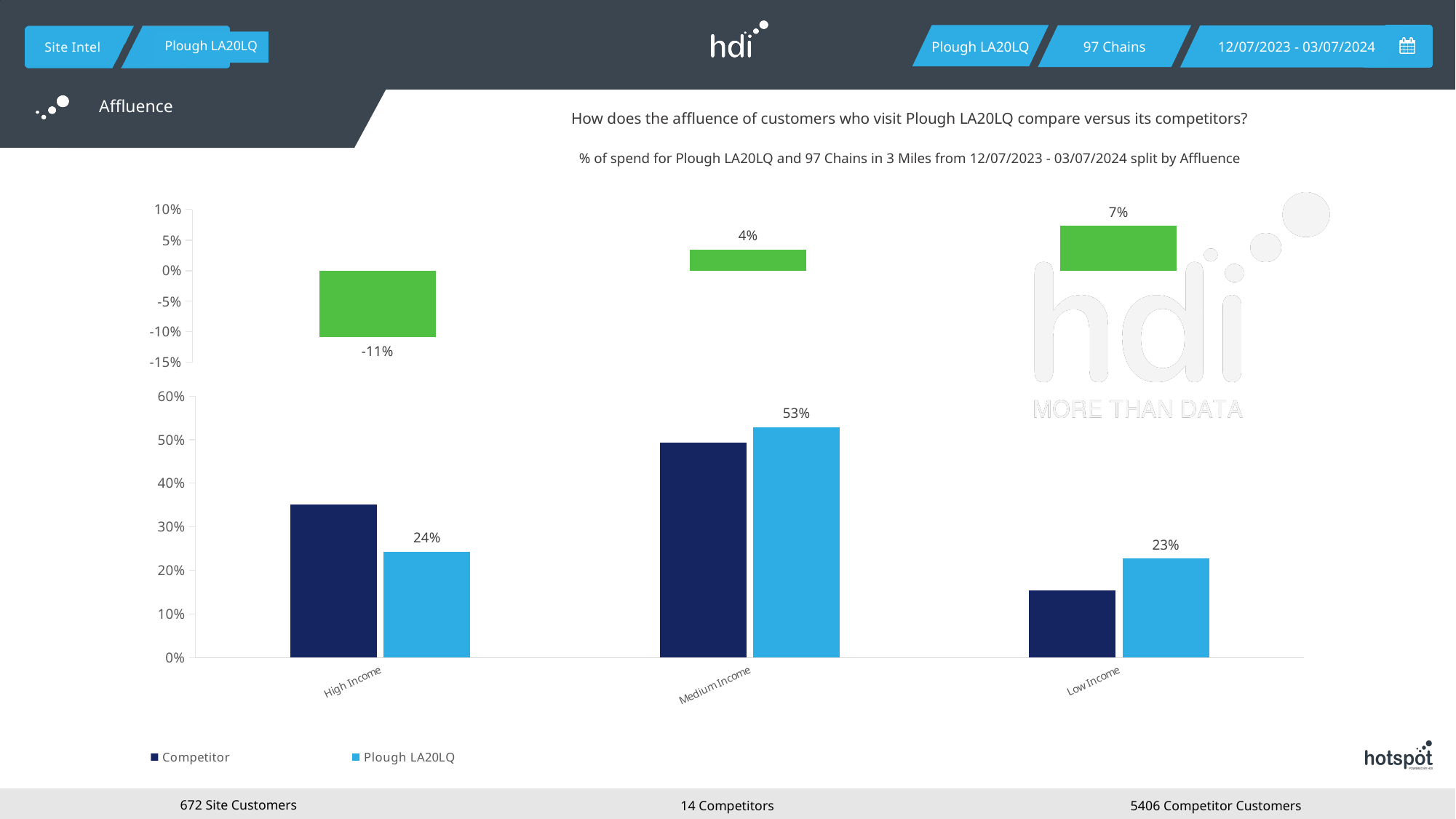
What type of chart is the bottom chart? Bar chart How many series does the legend of the bottom bar chart list? 2 In the bottom bar chart, is the Competitor value for High Income greater or less than 30%? greater In the bottom bar chart, which is larger for Low Income: the Competitor value or the Plough LA20LQ value? Plough LA20LQ In the top chart (green bars), what is the value for Low Income? 7% In the top chart (green bars), what is the value for High Income? -11% In the bottom bar chart, what is the difference between the Plough LA20LQ values for Medium Income and High Income? 29% In the bottom bar chart, what is the value for Plough LA20LQ in the High Income category? 24% In the bottom bar chart, which category has the highest value for Plough LA20LQ? Medium Income In the bottom bar chart, what is the value for Plough LA20LQ in the Medium Income category? 53% In the top chart (green bars), which category has the lowest value? High Income In the bottom bar chart, is the Competitor value for Low Income greater or less than 20%? less